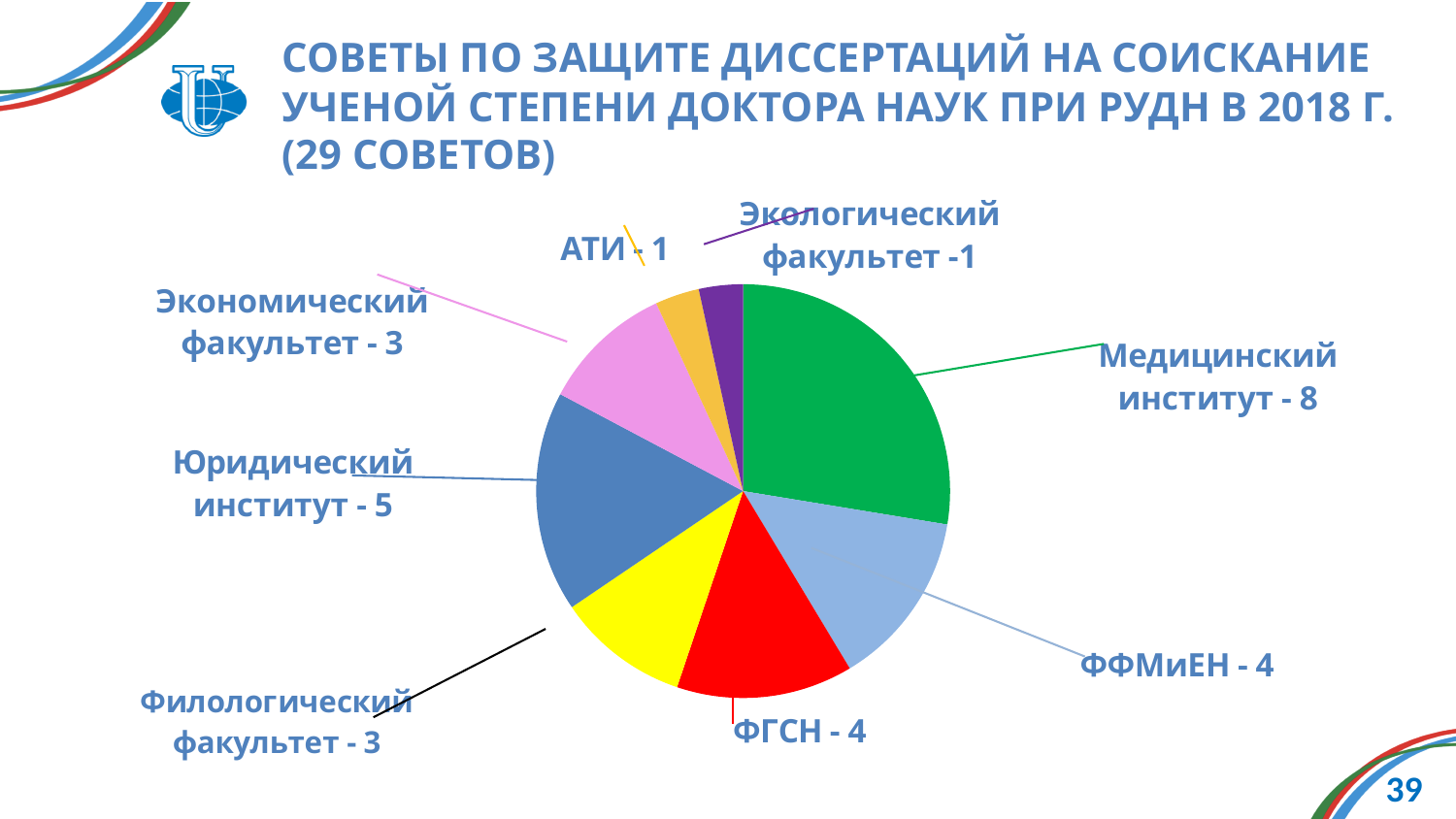
What kind of chart is shown on the slide? pie chart What is the value shown for ФФМиЕН? 4 What is the total number of councils shown in the chart title? 29 What colour is the slice for Медицинский институт? green What is the value shown for Юридический институт? 5 Which is larger, the value for Экономический факультет or the value for ФГСН? ФГСН How many slices does the pie chart have? 8 What is the value shown for АТИ? 1 How many councils does the Медицинский институт have according to the chart? 8 What is the difference between the values for Медицинский институт and Юридический институт? 3 Which category has the largest slice of the pie? Медицинский институт What share of the 29 councils does Медицинский институт represent? 8 of 29